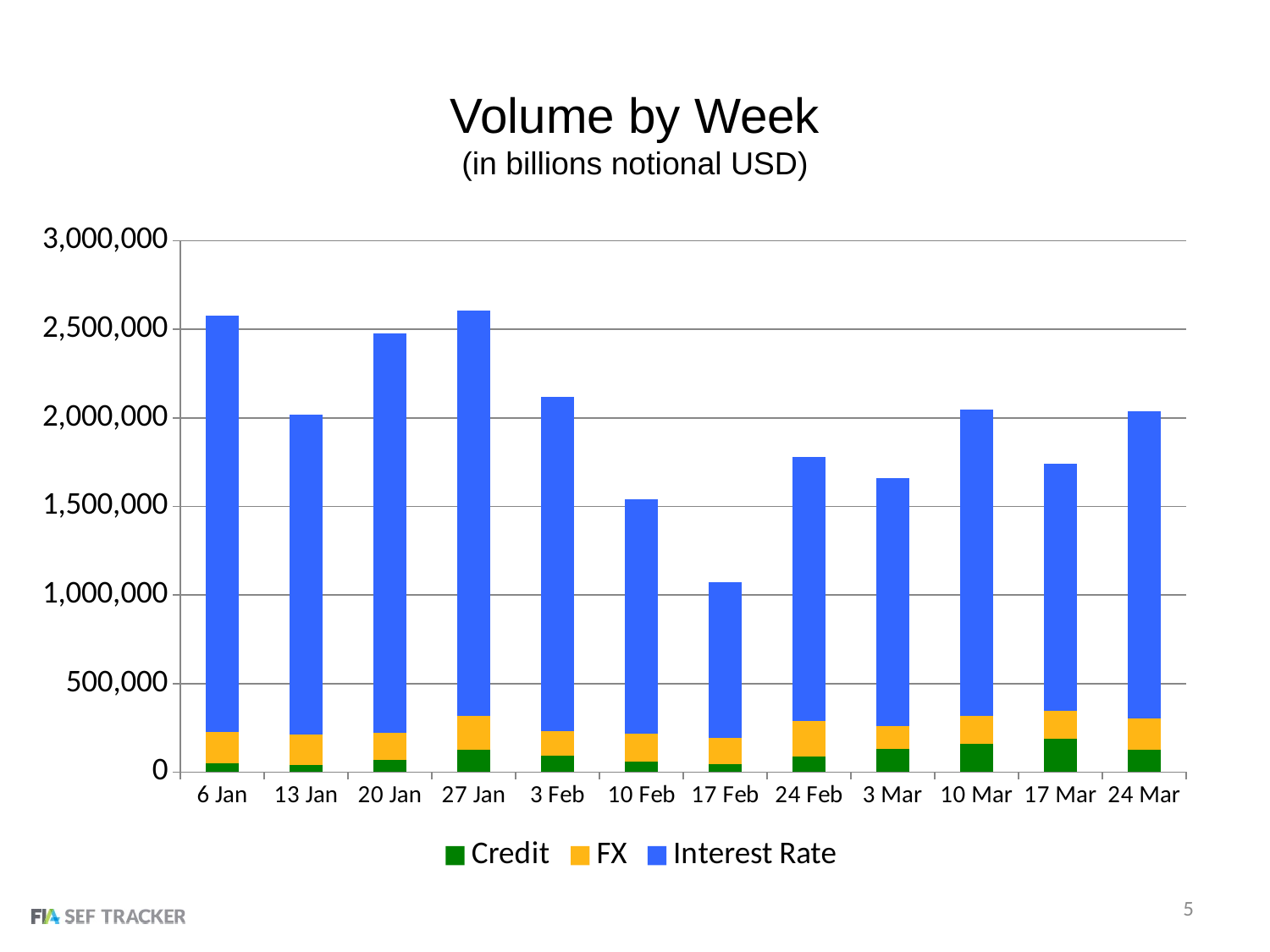
Is the total volume for 6 Jan greater or less than 2,500,000? greater Which week has the larger total volume, 10 Mar or 3 Mar? 10 Mar Is the total volume for 3 Mar greater or less than 2,000,000? less What kind of chart is shown on the slide? Stacked bar chart Which week has the larger total volume, 6 Jan or 13 Jan? 6 Jan Is the total volume for 17 Feb greater or less than 1,500,000? less Which week has the lowest total volume? 17 Feb How many weeks are shown on the x axis? 12 How many series does the legend list? 3 Which series is shown in green in the legend? Credit Do the total volumes rise or fall from 27 Jan to 17 Feb? fall